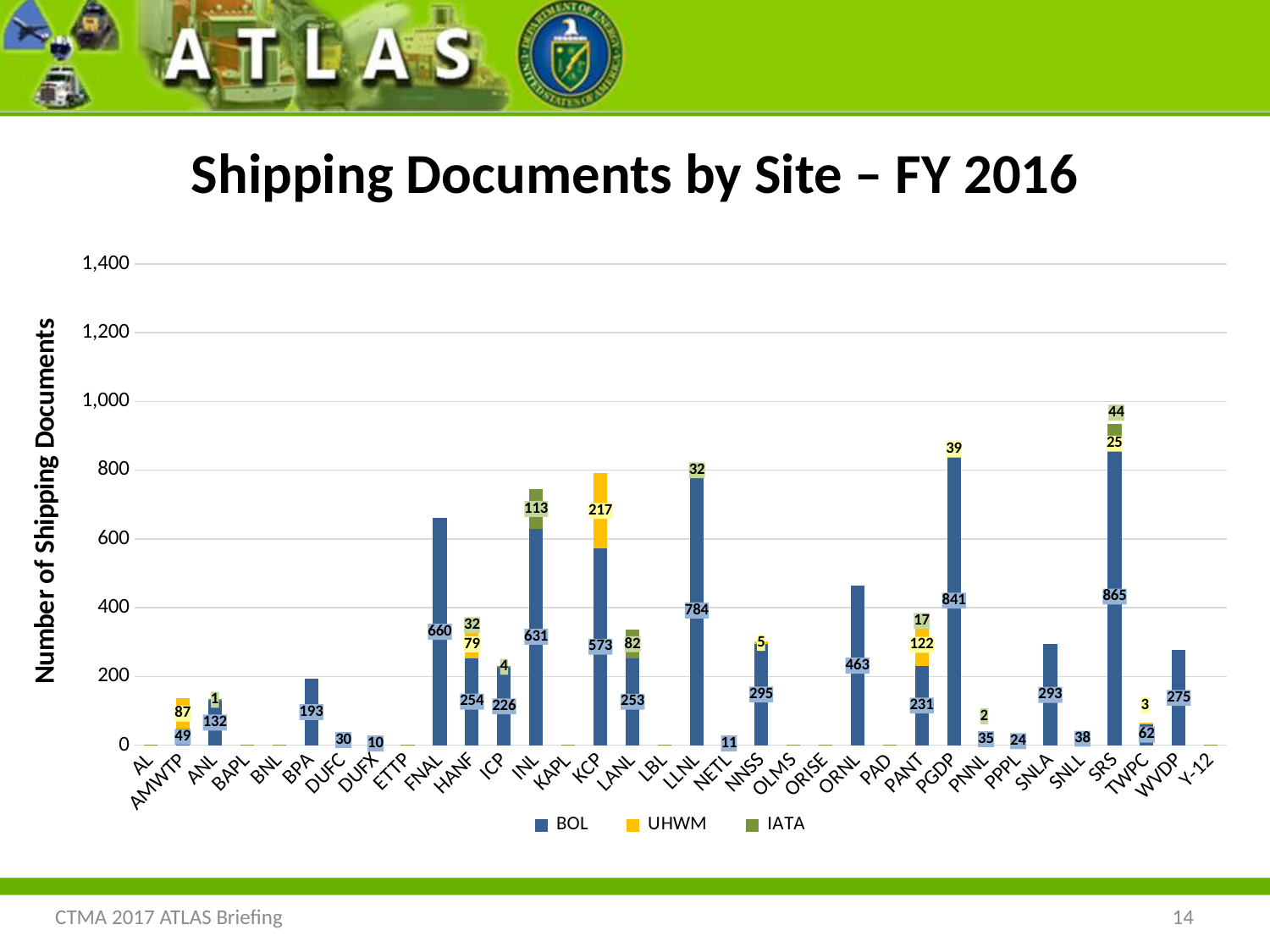
Which site has the highest BOL value? SRS How many sites are shown on the x axis? 34 Which site has the larger BOL value, ORNL or SNLA? ORNL What is the BOL value for FNAL? 660 How many series does the legend list? 3 What is the total of the stacked bar for SRS? 934 Is the BOL value for WVDP greater or less than 200? greater What is the UHWM value for KCP? 217 What is the difference between the BOL values for PGDP and LLNL? 57 What are the series listed in the legend? BOL, UHWM, IATA What kind of chart is shown on the slide? bar chart What is the IATA value for INL? 113